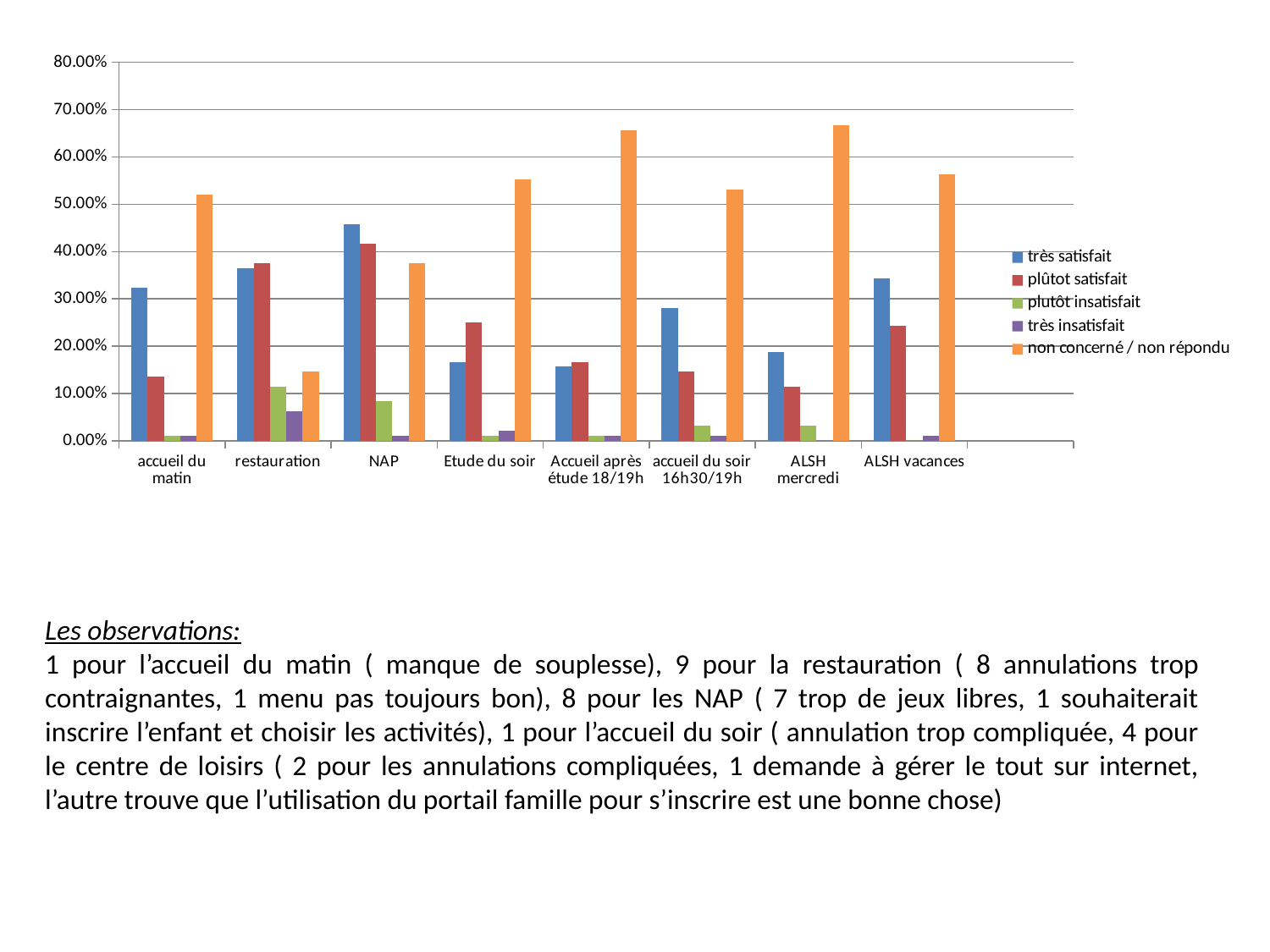
What kind of chart is shown on the slide? bar chart Which colour represents 'non concerné / non répondu' in the legend? orange Is the 'non concerné / non répondu' value for ALSH mercredi greater or less than 60.00%? greater How many categories are shown on the x axis? 8 Which category has the highest value for 'très satisfait'? NAP Which category has the highest value for 'très insatisfait'? restauration Which category has the lowest value for 'non concerné / non répondu'? restauration How many series does the legend list? 5 Is the 'très satisfait' value for NAP greater or less than 40.00%? greater Is the 'non concerné / non répondu' value for restauration greater or less than 20.00%? less For Etude du soir, which is larger: 'très satisfait' or 'plûtot satisfait'? plûtot satisfait